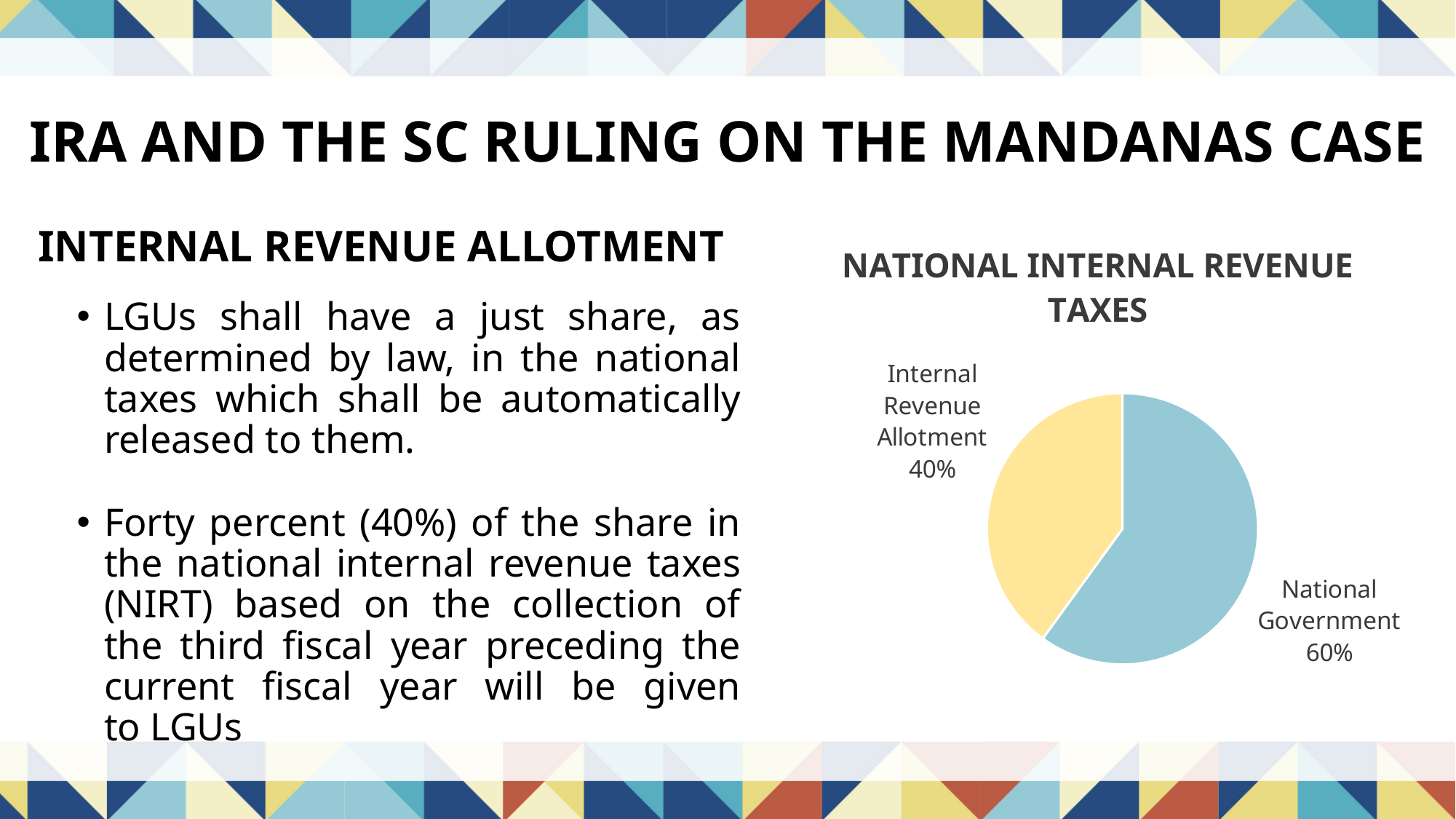
What is the difference between the National Government share and the Internal Revenue Allotment share? 20% What share of the pie does the Internal Revenue Allotment slice represent? 40% How many slices does the pie chart have? 2 What kind of chart is shown on the slide? Pie chart Which is larger, the National Government share or the Internal Revenue Allotment share? National Government Which slice of the pie is the largest? National Government What is the total of the two slices shown in the pie chart? 100% Which slice of the pie is the smallest? Internal Revenue Allotment What colour is the Internal Revenue Allotment slice? Yellow What is the title of the chart? NATIONAL INTERNAL REVENUE TAXES What share of the pie does the National Government slice represent? 60%